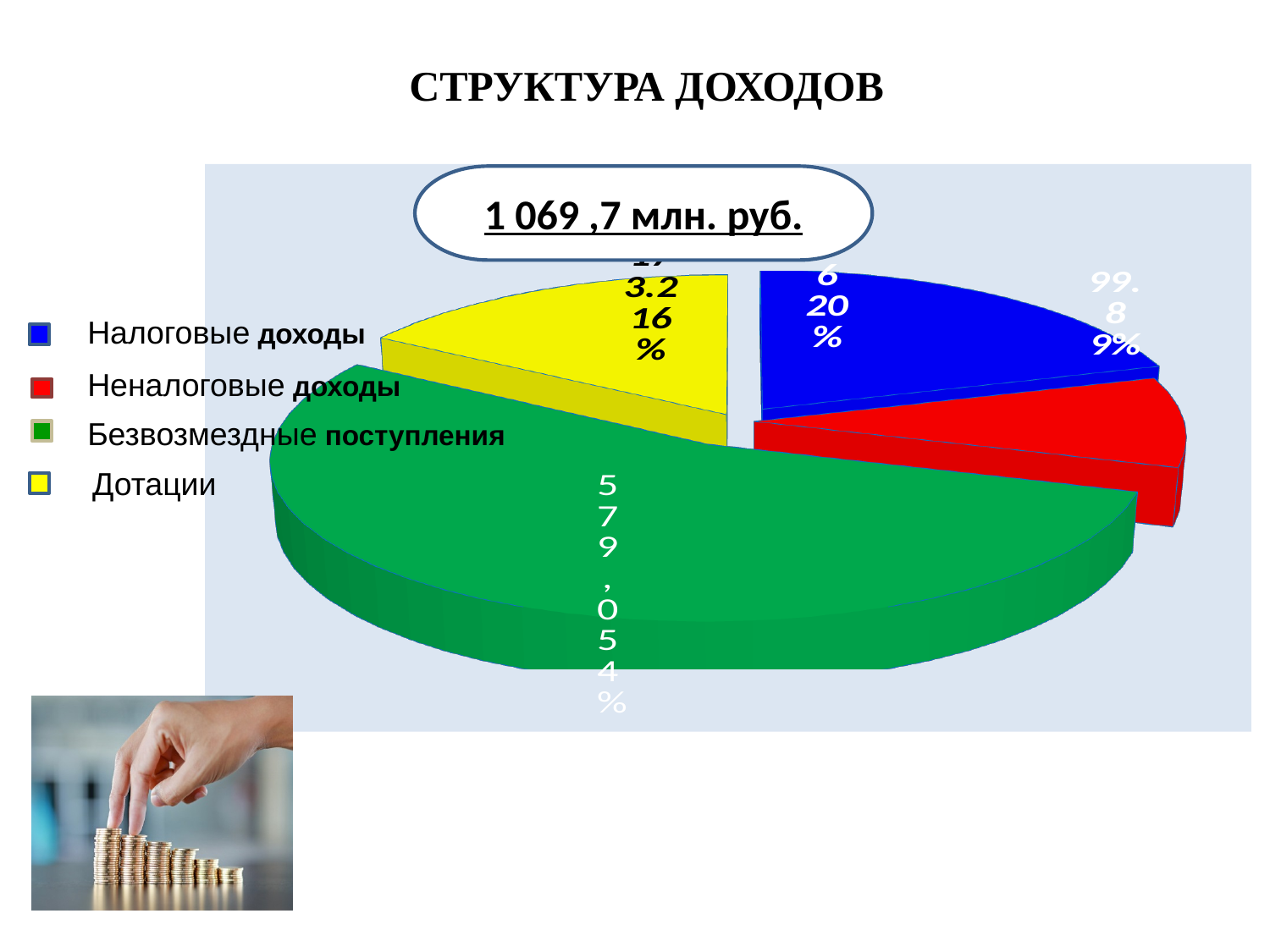
What kind of chart is shown on the slide? pie chart Which is larger, the share for Налоговые доходы or the share for Дотации? Налоговые доходы Which category has the largest share of the pie? Безвозмездные поступления What share of the pie is Безвозмездные поступления? 54% What total amount is shown in the box above the pie chart? 1 069 ,7 млн. руб. What share of the pie is Дотации? 16% What share of the pie is Налоговые доходы? 20% What colour represents Дотации in the pie chart? yellow Which category has the smallest share of the pie? Неналоговые доходы How many slices does the pie chart have? 4 What is the difference in percentage points between the share for Безвозмездные поступления and the share for Налоговые доходы? 34%